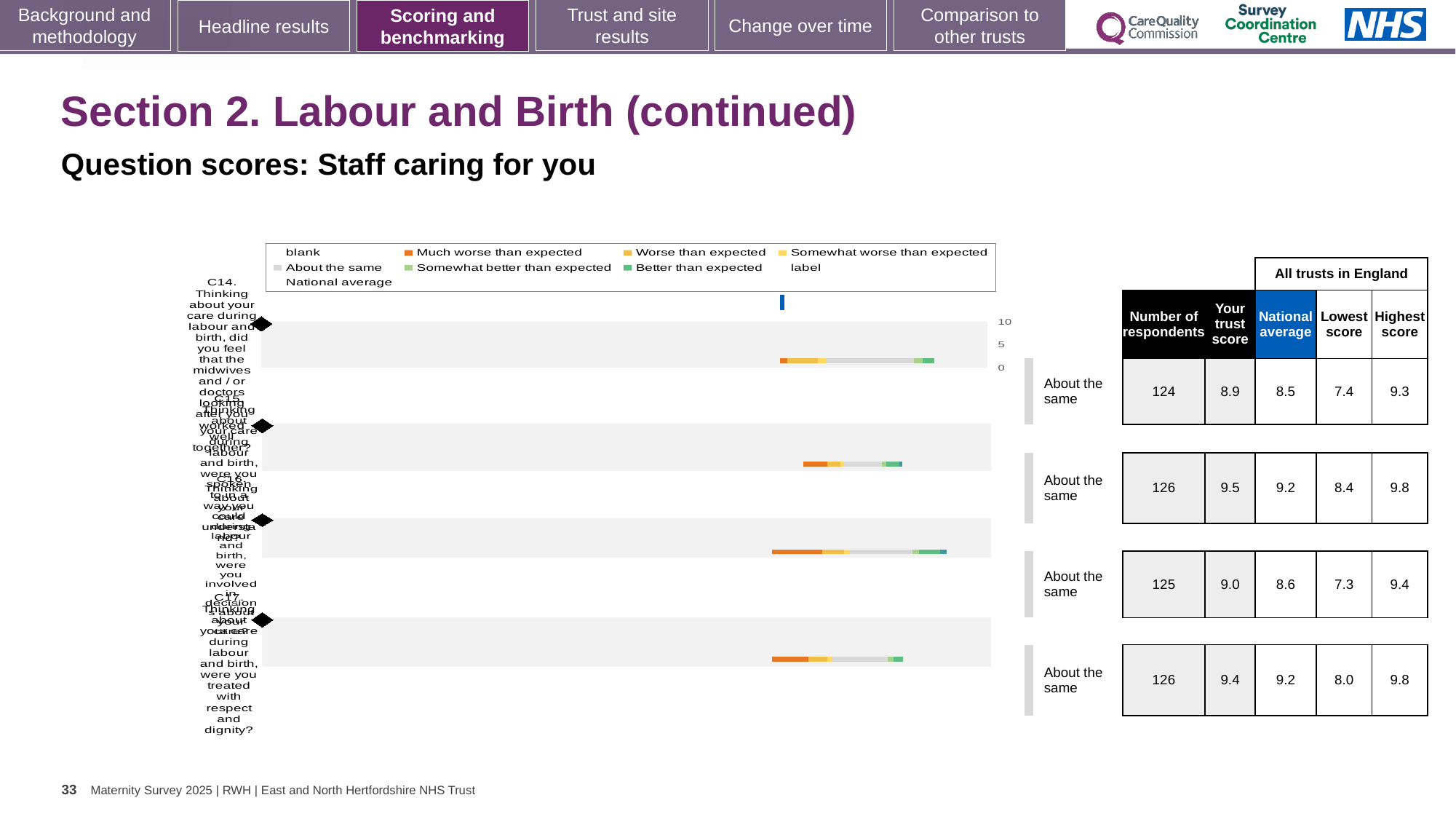
What is the highest tick value shown on the chart's score axis? 10 In the table beside the chart, what is the 'Lowest score' for the fourth row (C17)? 8.0 What benchmark label is shown next to the first bar (C14) in the chart? About the same What kind of chart is shown on the slide? bar chart In the table beside the chart, what is the 'Number of respondents' for the third row (C16)? 125 How many question rows (bars) are plotted in the chart? 4 In the table beside the chart, what is the 'National average' for the second row (C15)? 9.2 In the table beside the chart, is the 'Your trust score' for the second row (C15) larger or smaller than the 'Your trust score' for the third row (C16)? larger In the chart legend, which colour represents 'Much worse than expected'? orange In the table beside the chart, which row has the lowest 'Your trust score'? the first row (C14) In the table beside the chart, what is the difference between the 'Your trust score' and the 'National average' for the first row (C14)? 0.4 In the table beside the chart, what is the 'Your trust score' for the first row (C14)? 8.9